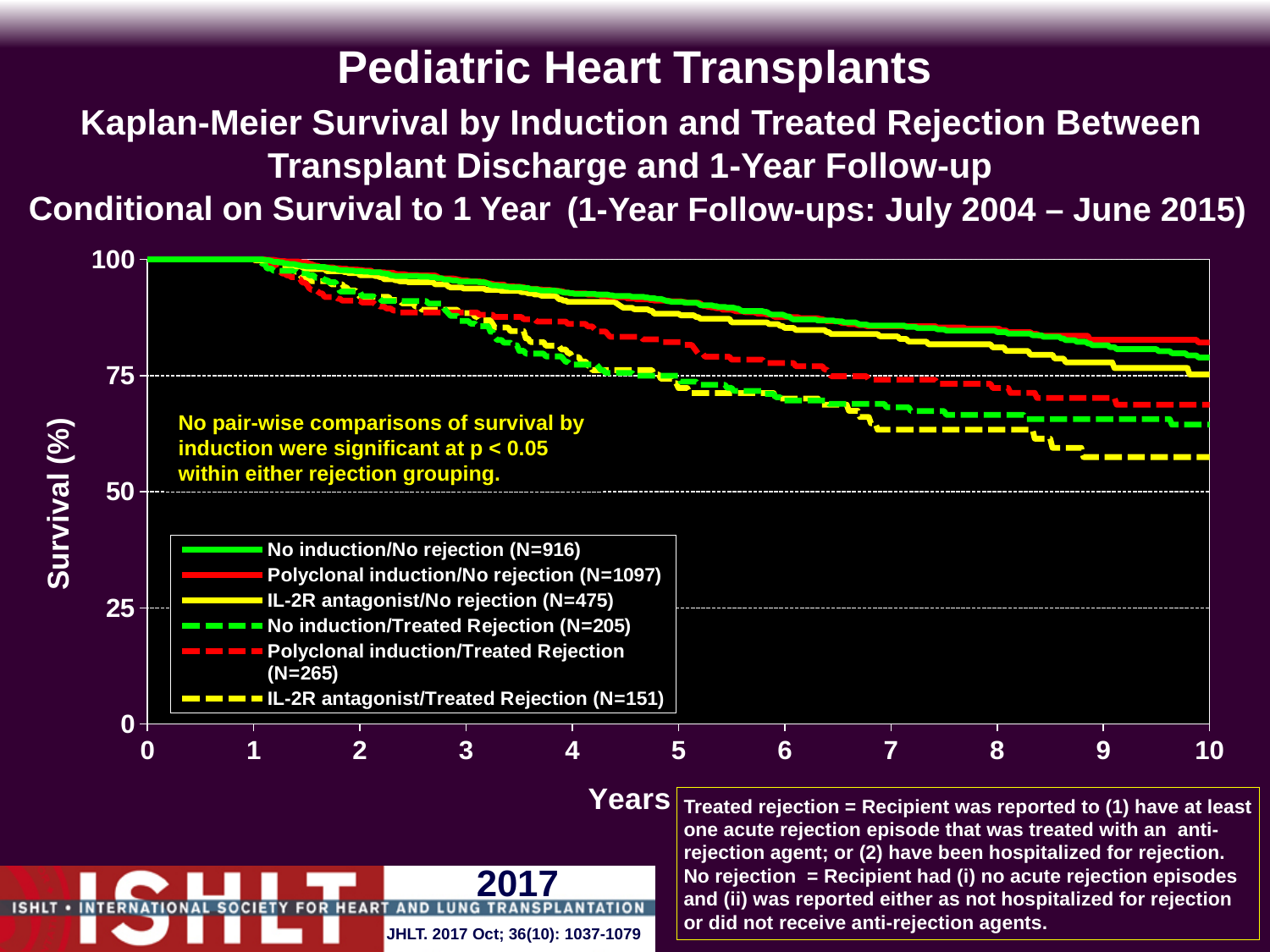
At 10 years, which has higher survival: No induction/No rejection or No induction/Treated Rejection? No induction/No rejection At 10 years, is survival for No induction/No rejection greater or less than 75? greater Which series has the lowest survival at 10 years? IL-2R antagonist/Treated Rejection (N=151) What is the label of the y axis? Survival (%) What is the N for the Polyclonal induction/No rejection series in the legend? 1097 Do the survival curves rise or fall as years increase? Fall At 7 years, is survival for IL-2R antagonist/Treated Rejection greater or less than 75? less What kind of chart is shown on the slide? Line chart At 10 years, is survival for IL-2R antagonist/Treated Rejection greater or less than 75? less How many series does the legend list? 6